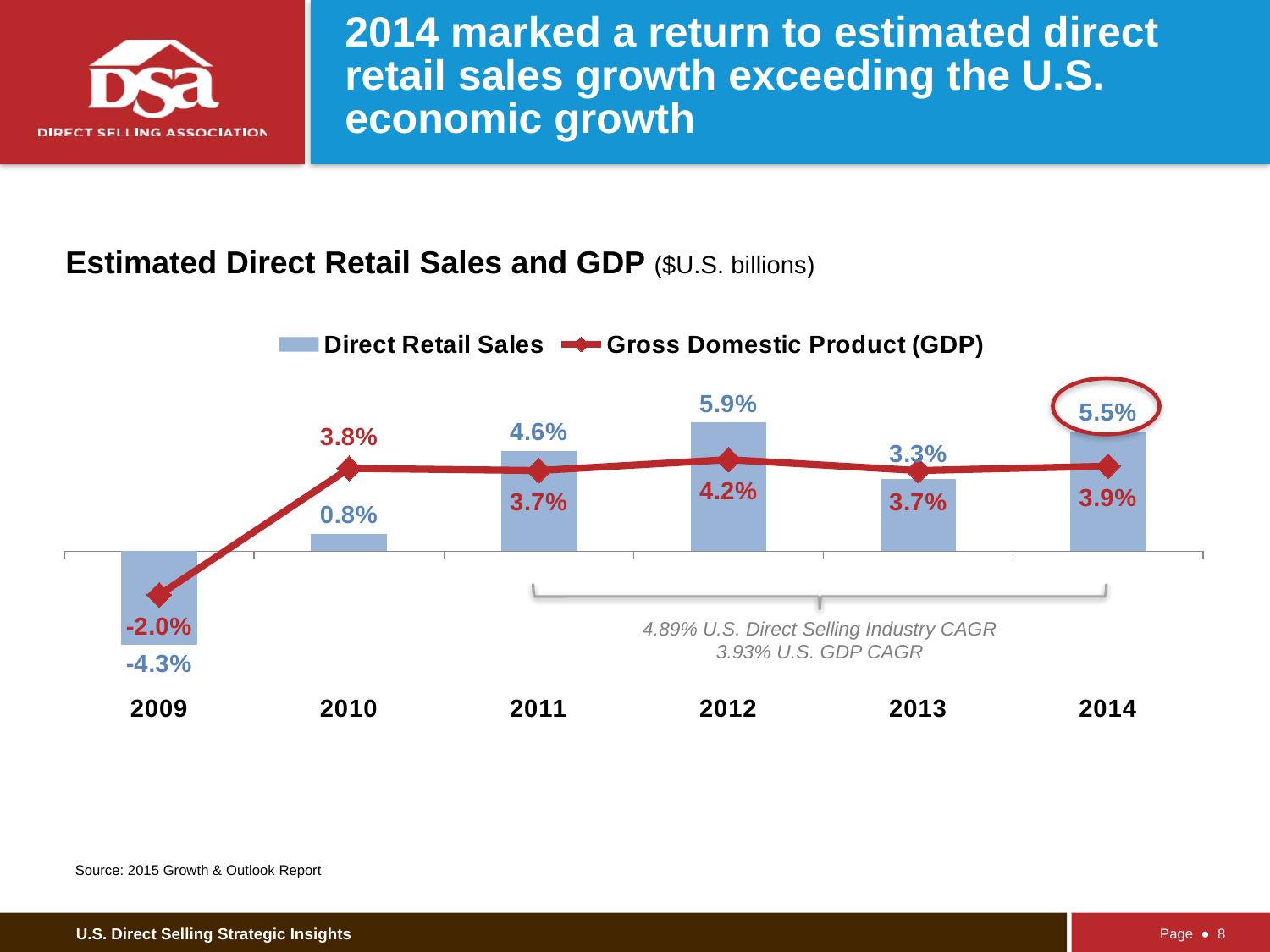
What is the difference between Direct Retail Sales and GDP growth in 2014? 1.6% What kind of chart is used to show Direct Retail Sales? Bar chart What is the title of the chart? Estimated Direct Retail Sales and GDP ($U.S. billions) What is the Gross Domestic Product (GDP) value for 2010? 3.8% What is the Direct Retail Sales value for 2009? -4.3% Which year has the highest Direct Retail Sales growth? 2012 Which year has the lowest GDP growth? 2009 How many years are shown on the x axis? 6 What is the GDP value for 2014? 3.9% In 2013, which is larger: Direct Retail Sales growth or GDP growth? GDP growth How many series does the legend list? 2 What is the Direct Retail Sales value for 2012? 5.9%